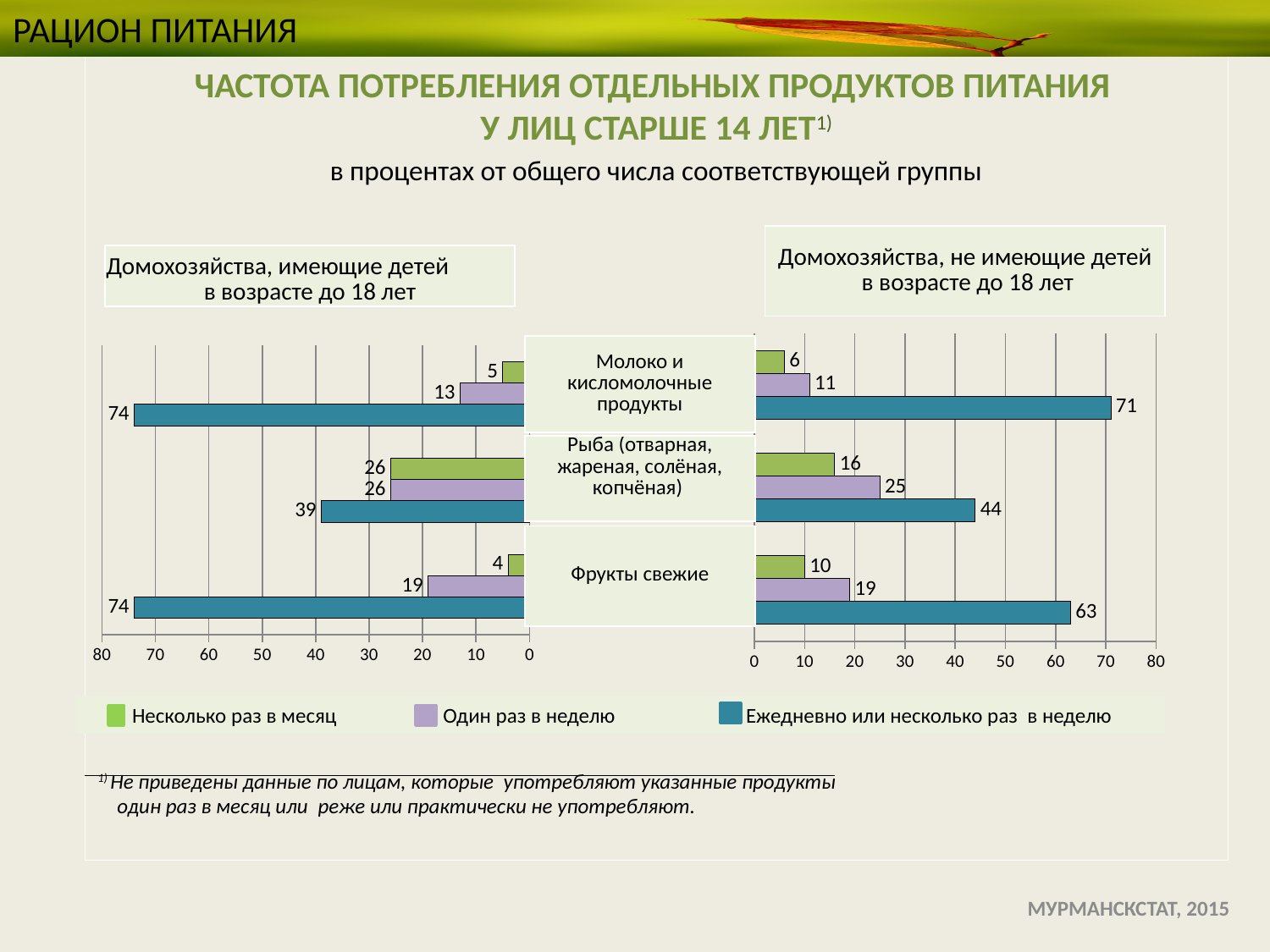
On the chart 'Домохозяйства, имеющие детей в возрасте до 18 лет', what is the difference between the 'Один раз в неделю' values for 'Фрукты свежие' and 'Молоко и кисломолочные продукты'? 6 For 'Рыба (отварная, жареная, солёная, копчёная)' with 'Ежедневно или несколько раз в неделю', which chart shows the larger value: 'Домохозяйства, имеющие детей' or 'Домохозяйства, не имеющие детей'? Домохозяйства, не имеющие детей в возрасте до 18 лет On the chart 'Домохозяйства, имеющие детей в возрасте до 18 лет', is the value for 'Ежедневно или несколько раз в неделю' for 'Фрукты свежие' greater or less than 70? greater How many product categories are shown on the chart 'Домохозяйства, не имеющие детей в возрасте до 18 лет'? 3 What type of chart is 'Домохозяйства, имеющие детей в возрасте до 18 лет'? bar chart On the chart 'Домохозяйства, не имеющие детей в возрасте до 18 лет', what is the difference between the 'Ежедневно или несколько раз в неделю' values for 'Молоко и кисломолочные продукты' and 'Фрукты свежие'? 8 On the chart 'Домохозяйства, не имеющие детей в возрасте до 18 лет', what is the value for 'Несколько раз в месяц' for 'Фрукты свежие'? 10 On the chart 'Домохозяйства, не имеющие детей в возрасте до 18 лет', what is the value for 'Один раз в неделю' for 'Рыба (отварная, жареная, солёная, копчёная)'? 25 How many series does the legend list for the charts on the slide? 3 On the chart 'Домохозяйства, имеющие детей в возрасте до 18 лет', which category has the lowest value for 'Ежедневно или несколько раз в неделю'? Рыба (отварная, жареная, солёная, копчёная) On the chart 'Домохозяйства, не имеющие детей в возрасте до 18 лет', which category has the highest value for 'Ежедневно или несколько раз в неделю'? Молоко и кисломолочные продукты On the chart 'Домохозяйства, имеющие детей в возрасте до 18 лет', what is the value for 'Ежедневно или несколько раз в неделю' for 'Молоко и кисломолочные продукты'? 74